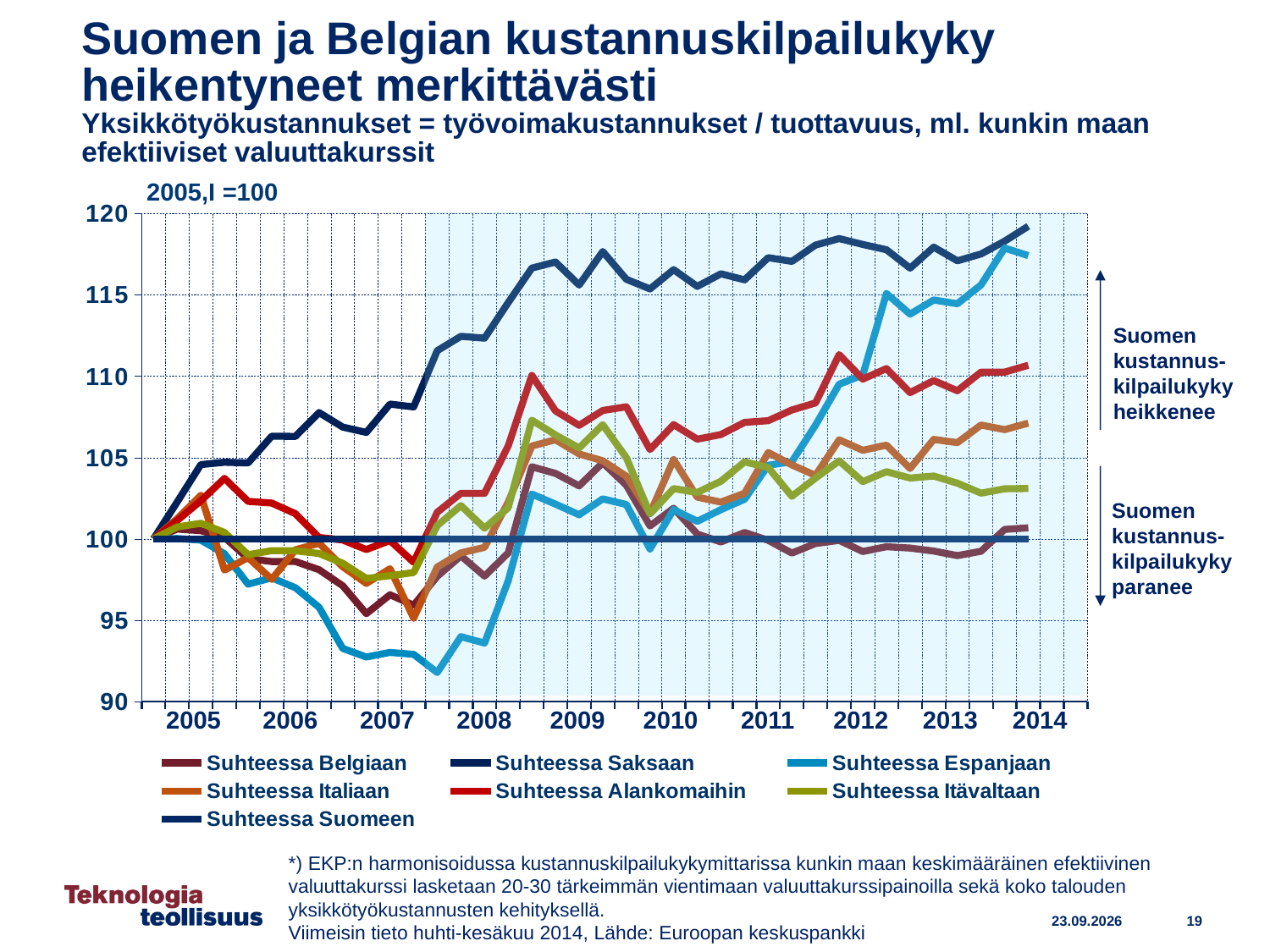
How many series does the legend list? 7 Is the value for Suhteessa Saksaan in 2014 greater or less than 115? greater Is the value for Suhteessa Itävaltaan in 2014 greater or less than 105? less Which series has the lowest value at the start of 2008? Suhteessa Espanjaan Does the Suhteessa Saksaan series rise or fall overall from 2005 to 2014? rise Which legend entry corresponds to the flat line at 100? Suhteessa Suomeen What kind of chart is shown on the slide? line chart Is the value for Suhteessa Espanjaan at the start of 2008 greater or less than 95? less What is the index base shown above the chart? 2005,I =100 How many years are labelled on the x axis? 10 Which series has the highest value in 2010? Suhteessa Saksaan